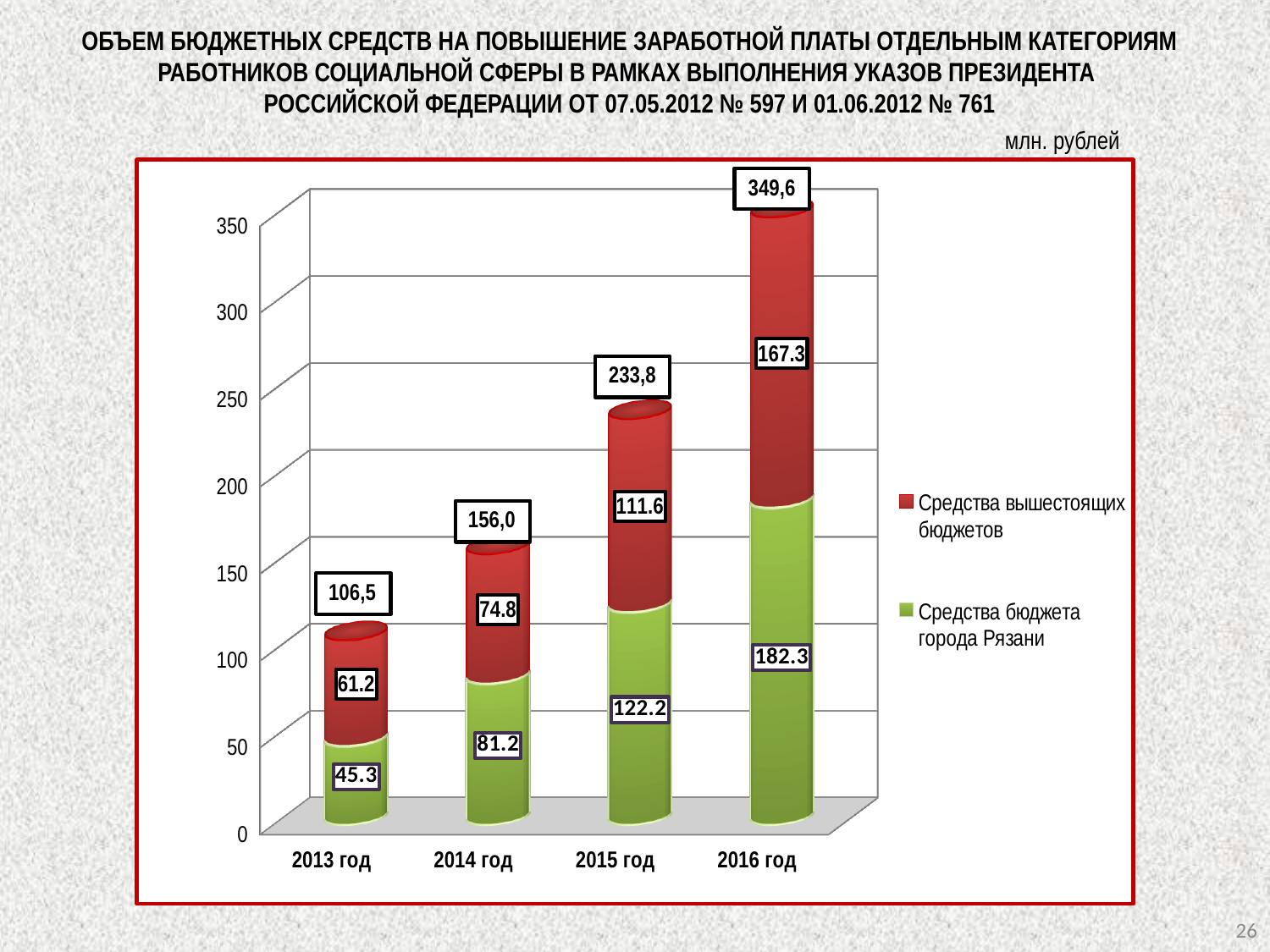
What is the difference between the Средства бюджета города Рязани values for 2015 год and 2014 год? 41.0 In 2016 год, which is larger: Средства вышестоящих бюджетов or Средства бюджета города Рязани? Средства бюджета города Рязани How many series does the legend list? 2 What is the total of the stacked bar for 2016 год? 349,6 What is the total of the stacked bar for 2014 год? 156,0 Do the total values rise or fall from 2013 год to 2016 год? rise Which year has the highest total? 2016 год What is the value for Средства вышестоящих бюджетов in 2015 год? 111.6 Which year has the lowest value for Средства вышестоящих бюджетов? 2013 год What is the value for Средства бюджета города Рязани in 2013 год? 45.3 What is the value for Средства бюджета города Рязани in 2016 год? 182.3 How many years are shown on the x axis? 4